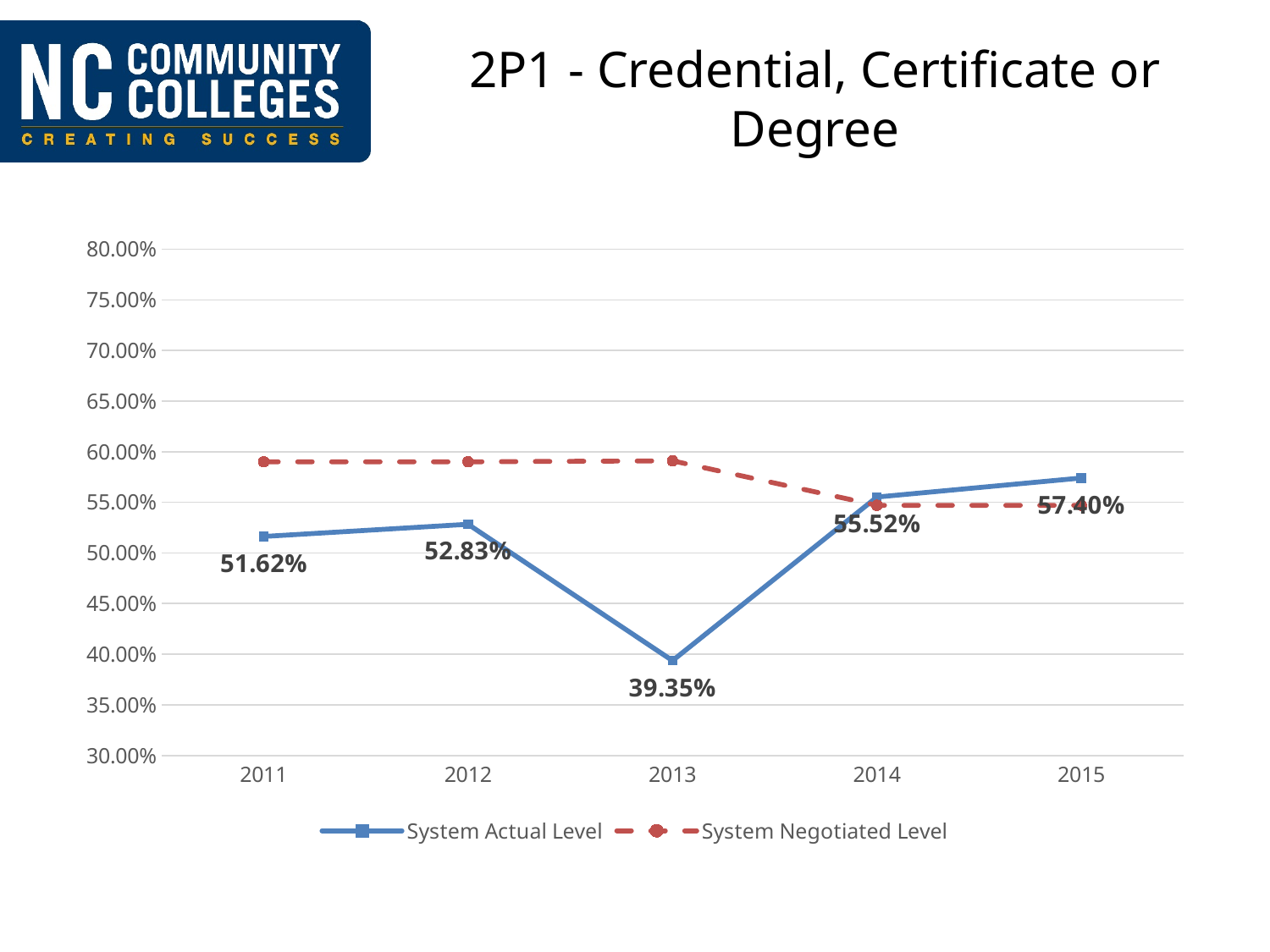
What is the System Actual Level for 2011? 51.62% What kind of chart is shown on the slide? line chart What is the System Actual Level for 2015? 57.40% What is the difference between the System Actual Level in 2014 and in 2013? 16.17% Which is larger, the System Actual Level in 2012 or in 2011? 2012 What is the System Actual Level for 2013? 39.35% Does the System Actual Level rise or fall from 2013 to 2015? rise How many years are shown on the x axis? 5 In which year is the System Actual Level lowest? 2013 How many series does the legend list? 2 Is the System Negotiated Level for 2011 greater or less than 55.00%? greater In which year is the System Actual Level highest? 2015